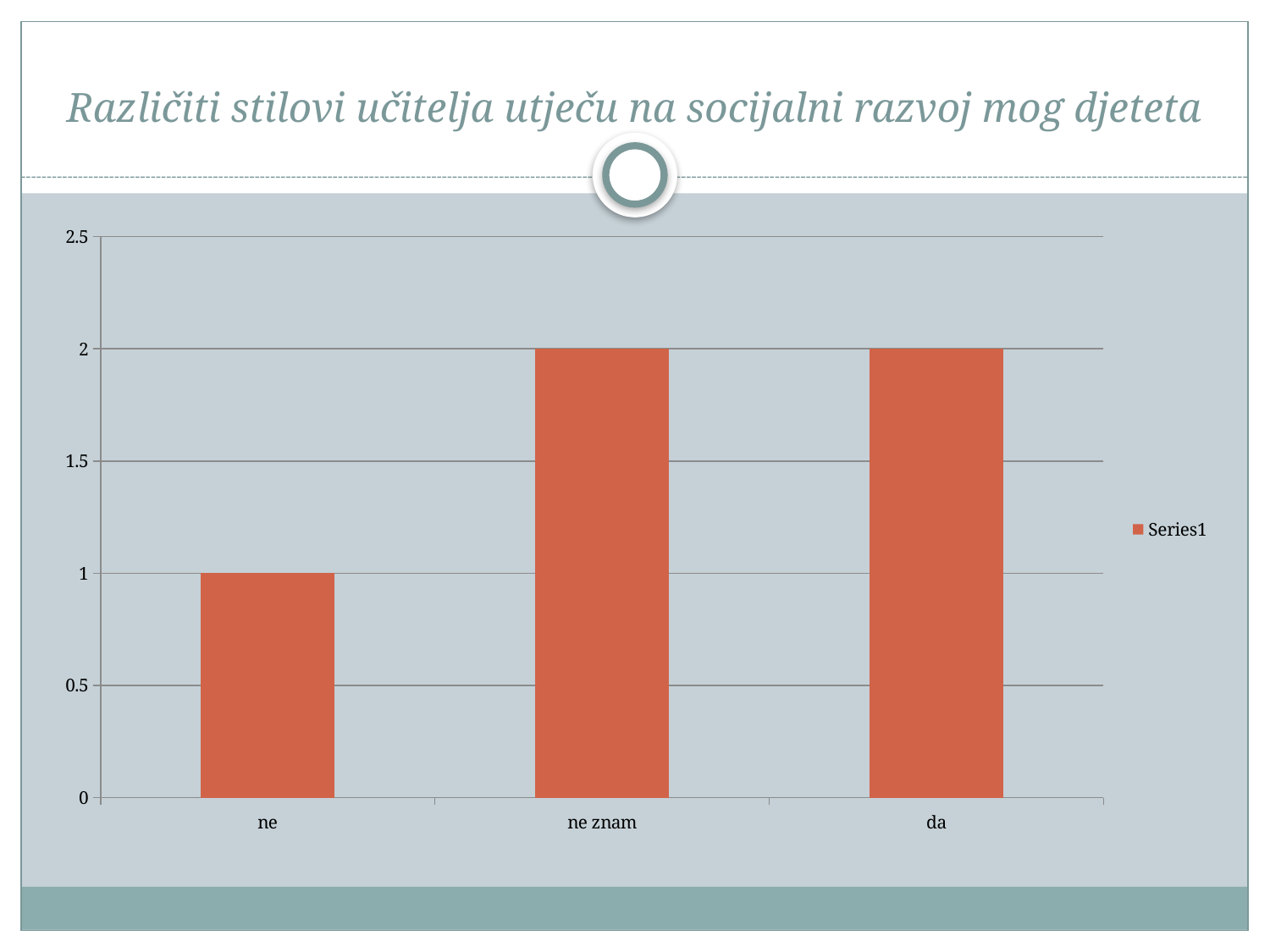
What is the value for "ne"? 1 Is the value for "ne" greater or less than 1.5? less Is the value for "da" greater or less than 1.5? greater How many series does the legend list? 1 What kind of chart is shown on the slide? bar chart What is the difference between the values for "da" and "ne"? 1 How many categories are shown on the x axis? 3 Which category has the lowest value? ne What is the value for "da"? 2 Which is larger, the value for "ne znam" or the value for "ne"? ne znam What is the value for "ne znam"? 2 What is the name of the series shown in the legend? Series1